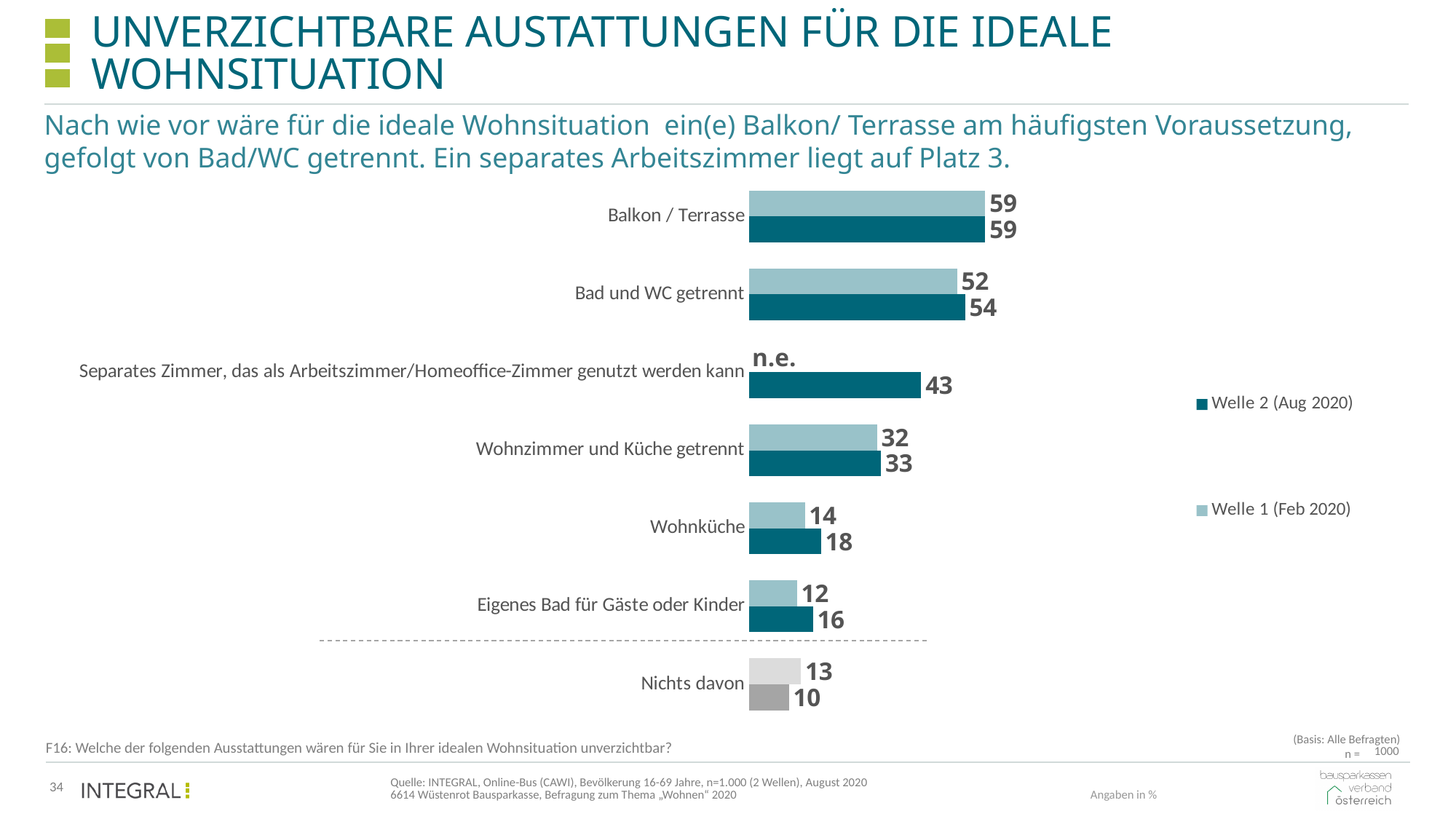
Which category has the lowest Welle 2 (Aug 2020) value? Nichts davon What is the Welle 2 (Aug 2020) value for Separates Zimmer, das als Arbeitszimmer/Homeoffice-Zimmer genutzt werden kann? 43 What is the difference between the Welle 1 (Feb 2020) and Welle 2 (Aug 2020) values for Nichts davon? 3 Which category has the highest Welle 2 (Aug 2020) value? Balkon / Terrasse What kind of chart is shown on the slide? Bar chart What is the Welle 1 (Feb 2020) value for Wohnküche? 14 What is shown for Welle 1 (Feb 2020) for the category Separates Zimmer, das als Arbeitszimmer/Homeoffice-Zimmer genutzt werden kann? n.e. What is the Welle 2 (Aug 2020) value for Bad und WC getrennt? 54 Which is larger for Eigenes Bad für Gäste oder Kinder: the Welle 1 (Feb 2020) value or the Welle 2 (Aug 2020) value? Welle 2 (Aug 2020) How many categories are shown in the chart? 7 How many series does the legend list? 2 What is the difference between the Welle 2 (Aug 2020) and Welle 1 (Feb 2020) values for Wohnküche? 4